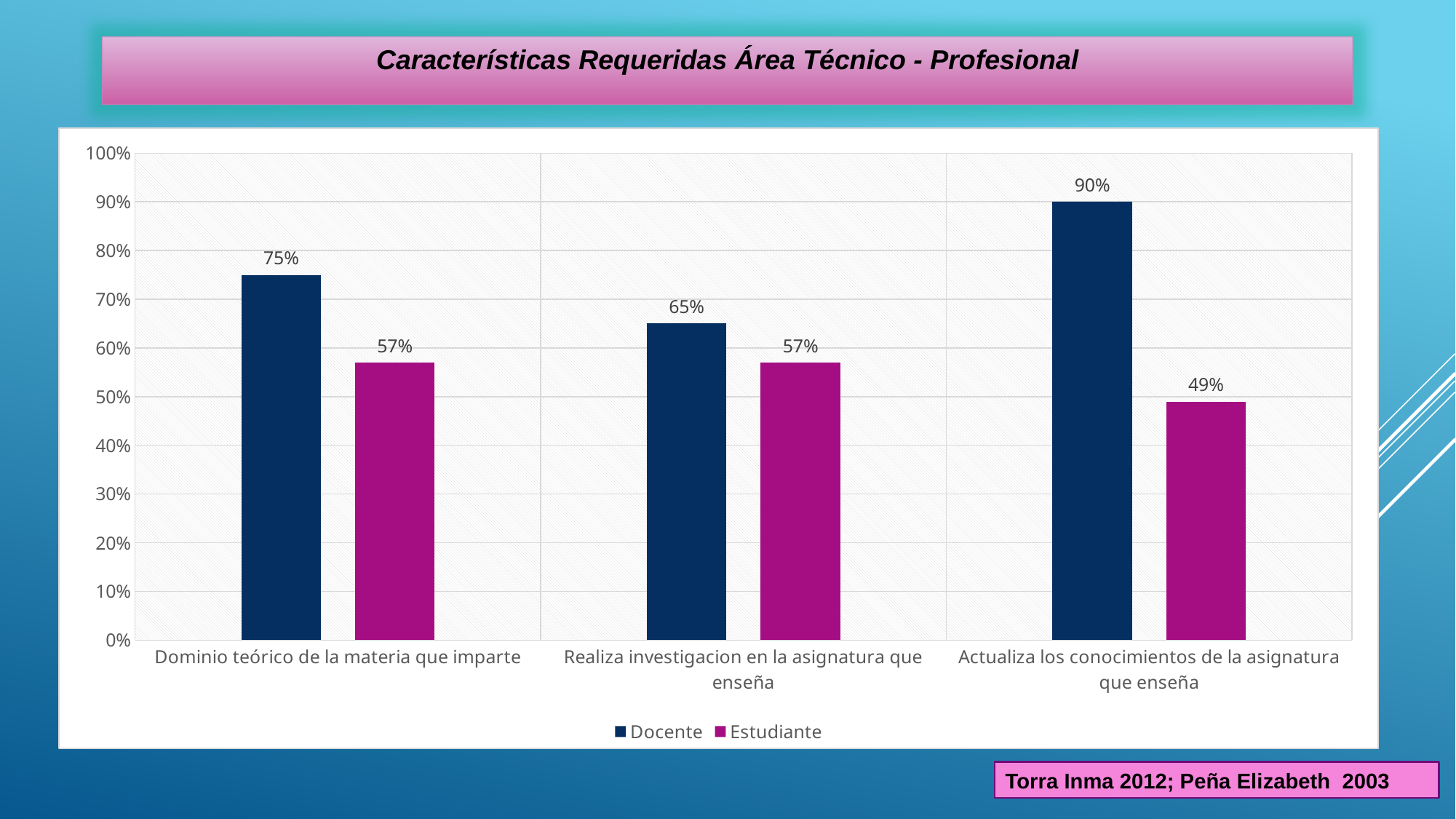
Which is larger for "Realiza investigacion en la asignatura que enseña": the Docente value or the Estudiante value? Docente Which category has the highest Docente value? Actualiza los conocimientos de la asignatura que enseña How many categories are shown on the x axis? 3 What is the difference between the Docente and Estudiante values for "Actualiza los conocimientos de la asignatura que enseña"? 41% What is the difference between the Docente and Estudiante values for "Dominio teórico de la materia que imparte"? 18% Which category has the lowest Estudiante value? Actualiza los conocimientos de la asignatura que enseña What kind of chart is shown on the slide? bar chart What is the Estudiante value for "Actualiza los conocimientos de la asignatura que enseña"? 49% What is the Docente value for "Dominio teórico de la materia que imparte"? 75% What is the Docente value for "Realiza investigacion en la asignatura que enseña"? 65% Is the Estudiante value for "Dominio teórico de la materia que imparte" greater or less than 50%? greater How many series does the legend list? 2